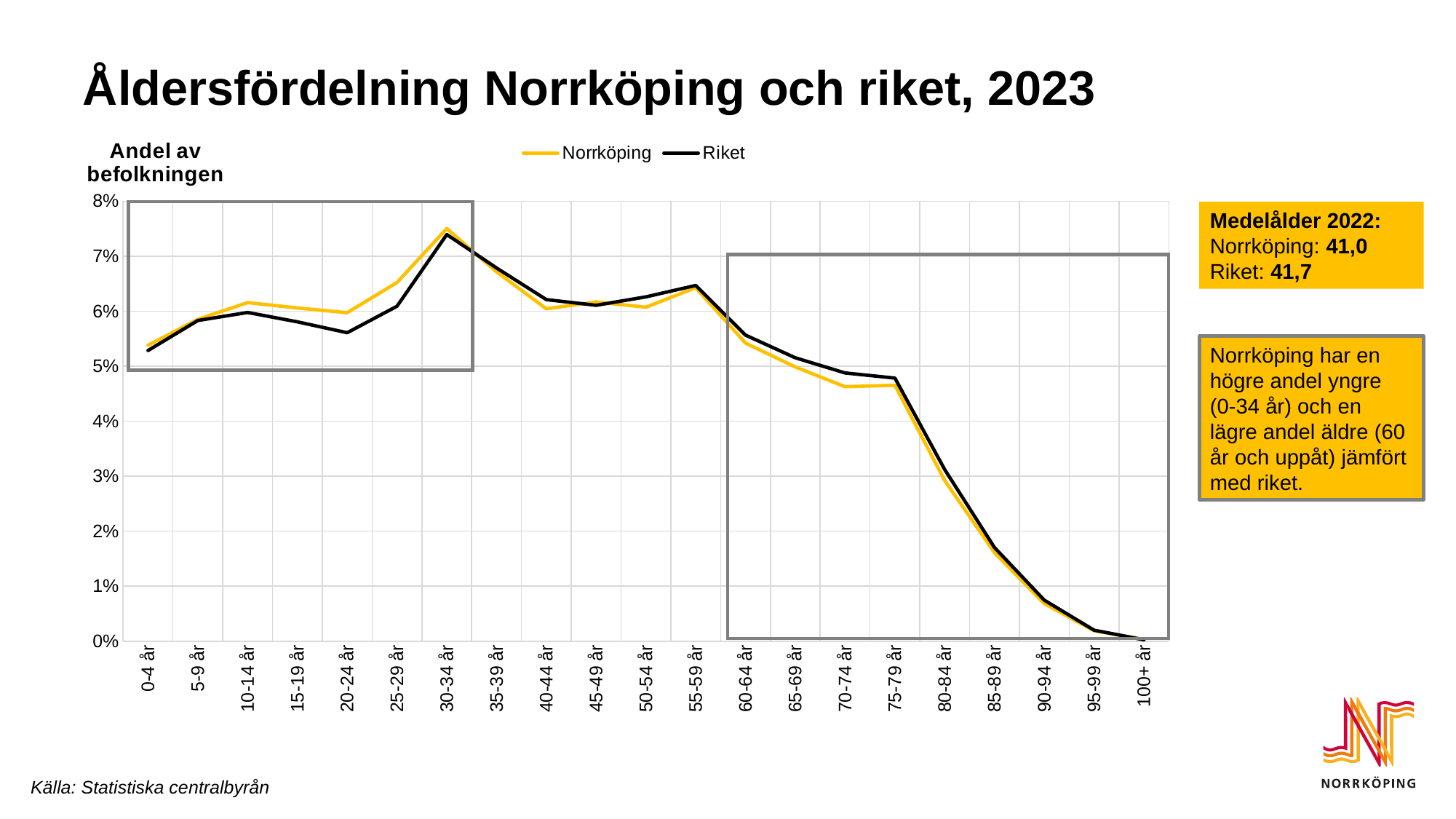
What kind of chart is shown on the slide? Line chart For the 70-74 år age group, which series has the higher value, Norrköping or Riket? Riket In which age group does the Riket series reach its highest value? 30-34 år How many series does the chart legend list? 2 Is the Riket value for 20-24 år greater or less than 6%? less For the 20-24 år age group, which series has the higher value, Norrköping or Riket? Norrköping In which age group does the Norrköping series reach its highest value? 30-34 år In which age group is the Norrköping series at its lowest value? 100+ år Do the values for both series rise or fall along the x axis from 55-59 år to 100+ år? Fall Is the Norrköping value for 30-34 år greater or less than 7%? greater How many age groups are shown along the x axis of the chart? 21 Is the Riket value for 85-89 år greater or less than 2%? less